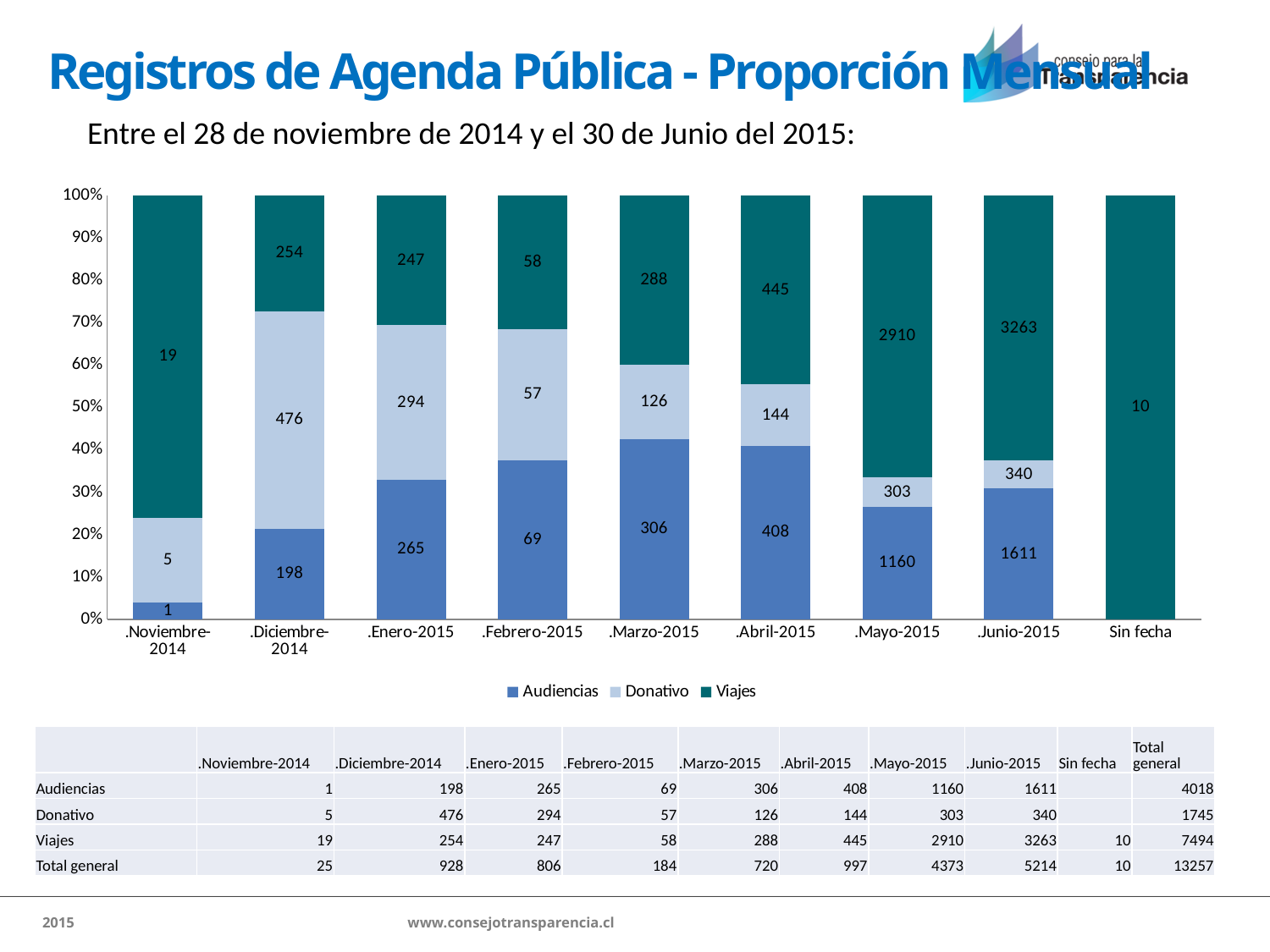
What is the total of the stacked bar for Abril-2015? 997 What is the title of the slide containing the chart? Registros de Agenda Pública - Proporción Mensual How many categories are shown on the x axis? 9 How many series does the legend list? 3 Which is larger, the Donativo value for Enero-2015 or for Marzo-2015? Enero-2015 What is the difference between the Audiencias values for Junio-2015 and Mayo-2015? 451 What is the value for Viajes in Mayo-2015? 2910 What is the value for Audiencias in Junio-2015? 1611 What is the value for Donativo in Diciembre-2014? 476 Which month has the highest value for Viajes? Junio-2015 Which month has the lowest value for Audiencias? Noviembre-2014 What kind of chart is shown on the slide? Stacked bar chart